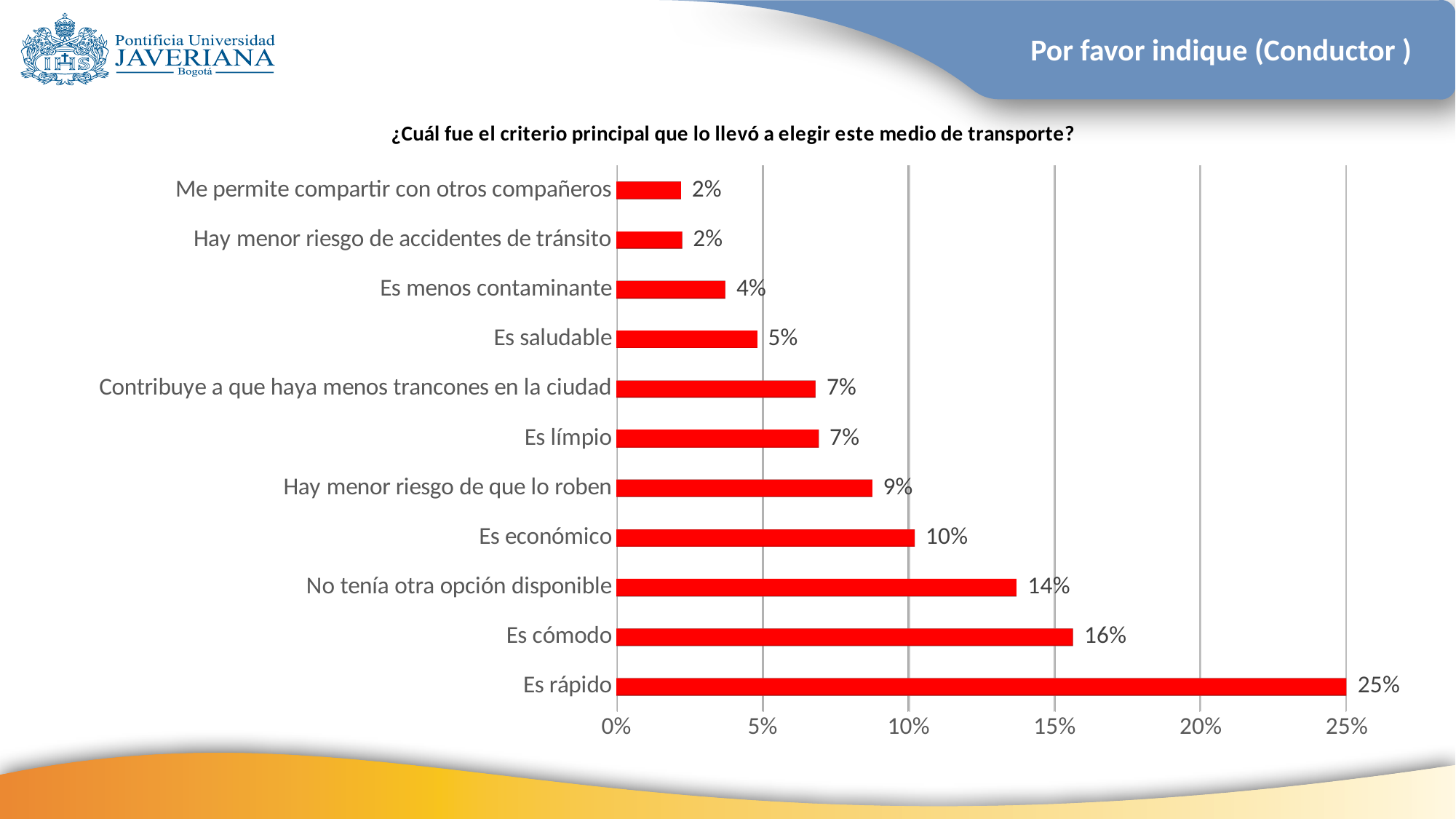
How many categories are shown in the chart? 11 What is the difference between the values for "Es cómodo" and "Es saludable"? 11% What is the value for "No tenía otra opción disponible"? 14% Which is larger, the value for "Hay menor riesgo de que lo roben" or the value for "Es menos contaminante"? Hay menor riesgo de que lo roben What is the value for "Es rápido"? 25% Which category has the highest value? Es rápido What kind of chart is shown on the slide? Bar chart What colour are the bars in the chart? Red What is the difference between the values for "Es rápido" and "Es cómodo"? 9% What is the value for "Es económico"? 10% Is the value for "Es cómodo" greater or less than 15%? greater What is the title of the chart? ¿Cuál fue el criterio principal que lo llevó a elegir este medio de transporte?